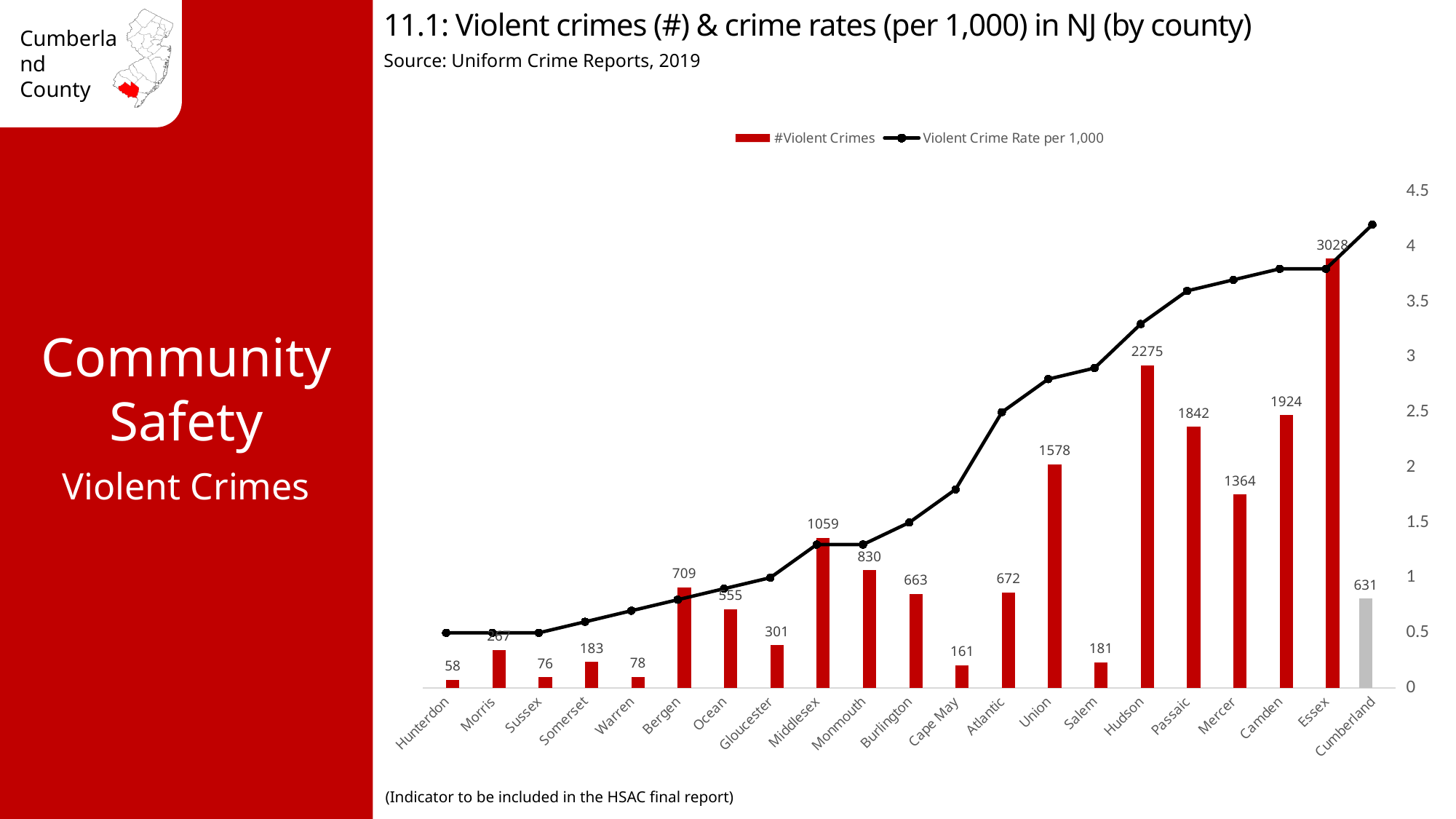
What is the difference in the number of violent crimes between Hudson and Passaic? 433 What is the number of violent crimes for Union? 1578 How many violent crimes are shown for Cumberland County? 631 Does the violent crime rate per 1,000 line generally rise or fall from left to right across the counties? rise Which county has the highest number of violent crimes? Essex How many counties are shown on the x axis of the chart? 21 Which county has more violent crimes, Camden or Passaic? Camden Is the violent crime rate per 1,000 for Hunterdon greater or less than 1? less Which county has the lowest number of violent crimes? Hunterdon What is the number of violent crimes for Essex? 3028 Is the violent crime rate per 1,000 for Cumberland greater or less than 4? greater How many series does the legend list? 2